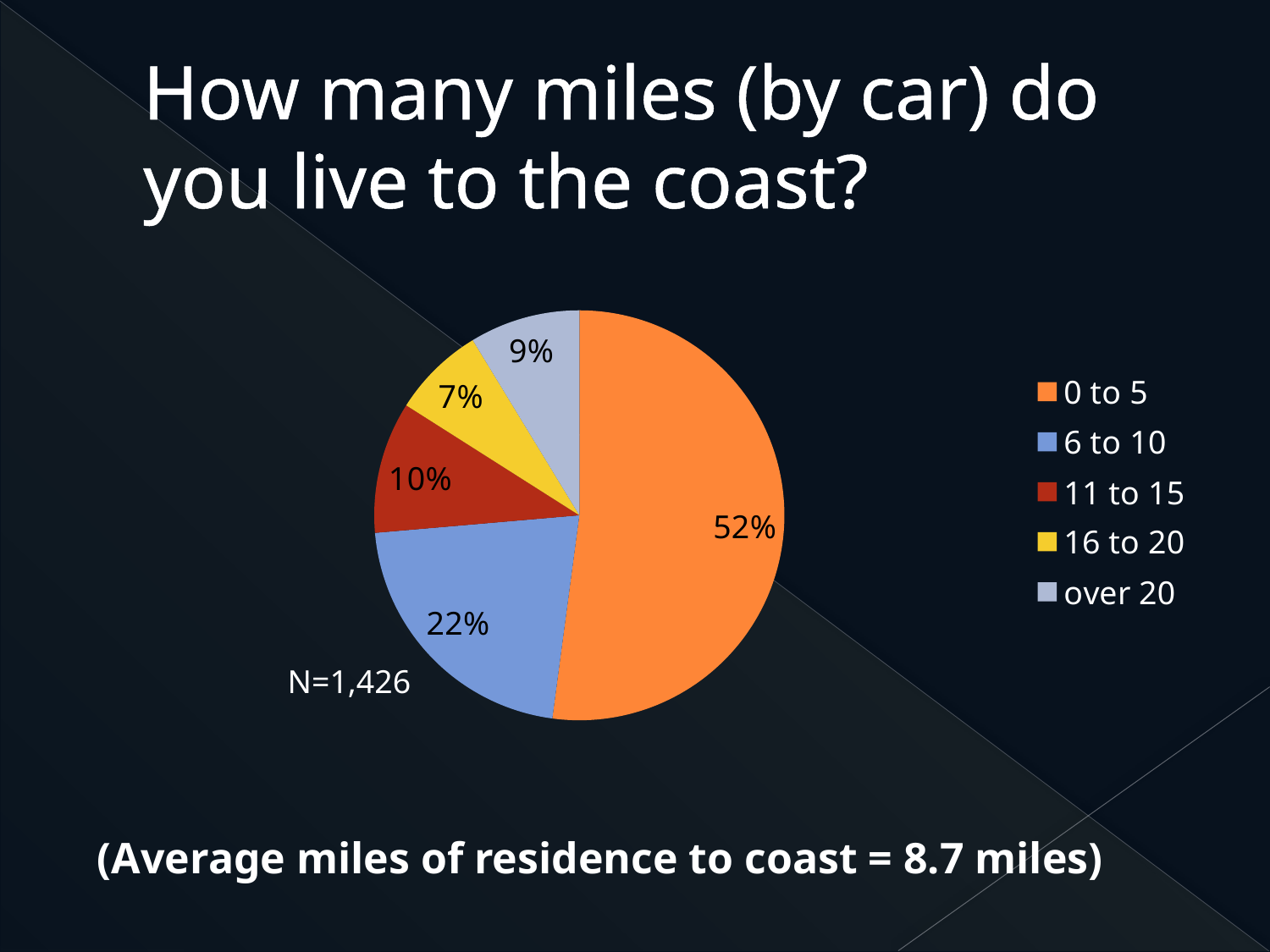
What is the difference in percentage points between the 0 to 5 slice and the 6 to 10 slice? 30 Which category has the smallest slice of the pie? 16 to 20 Which slice is larger, over 20 or 16 to 20? over 20 What share of respondents live 11 to 15 miles from the coast? 10% What share of respondents live 16 to 20 miles from the coast? 7% What kind of chart is shown on the slide? pie chart Which category has the largest slice of the pie? 0 to 5 What share of respondents live over 20 miles from the coast? 9% How many categories does the legend list? 5 What is the sample size (N) shown next to the pie chart? N=1,426